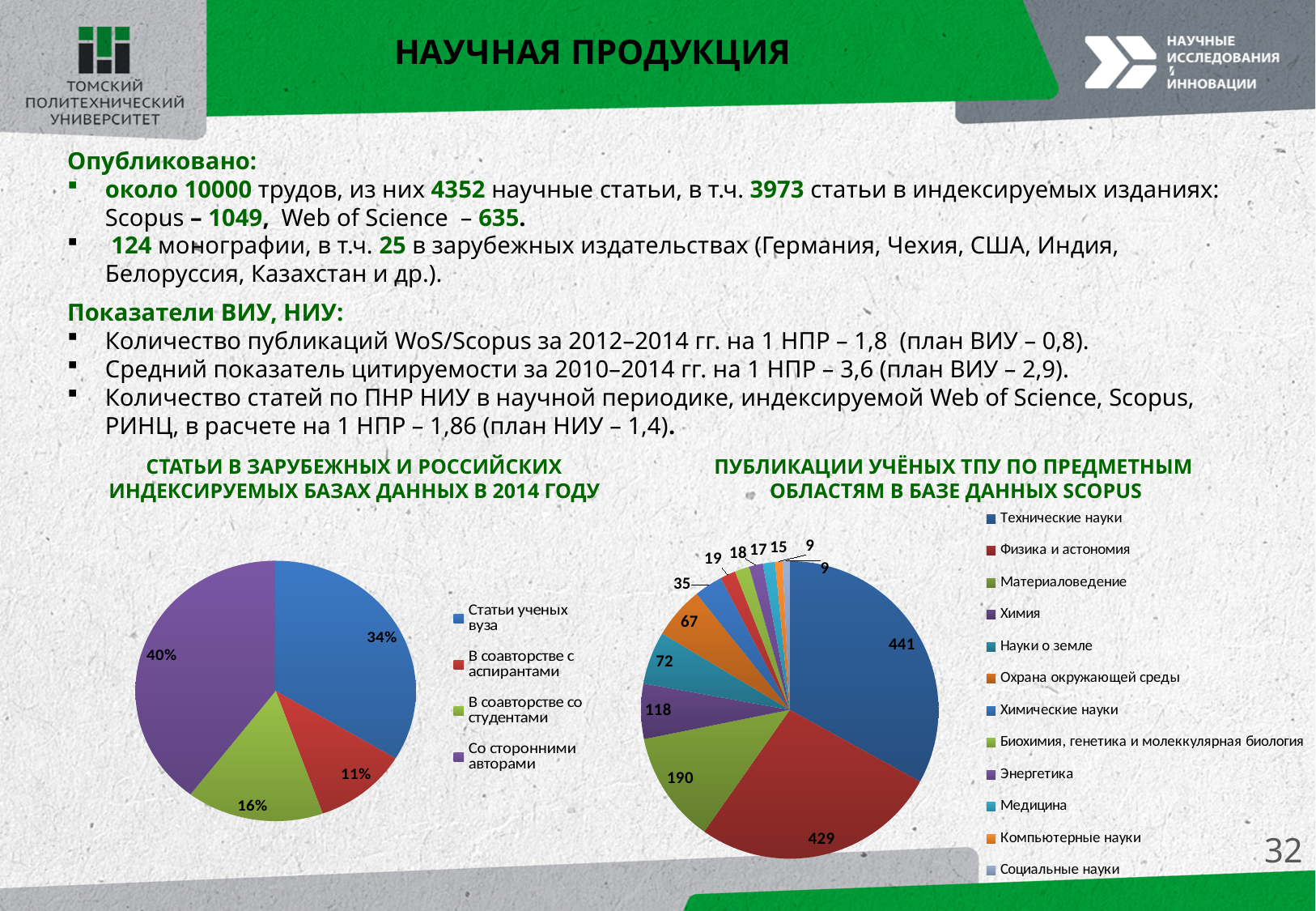
In the left pie chart, which category has the smallest share? В соавторстве с аспирантами In the right pie chart, which subject area has the highest number of publications? Технические науки How many categories does the legend of the left pie chart list? 4 In the left pie chart, what is the difference between the shares for 'Статьи ученых вуза' and 'В соавторстве со студентами'? 18% In the right pie chart (Публикации учёных ТПУ по предметным областям в базе данных Scopus), what is the value for 'Технические науки'? 441 In the right pie chart, which is larger: 'Науки о земле' or 'Охрана окружающей среды'? Науки о земле In the right pie chart, what is the value for 'Материаловедение'? 190 In the left pie chart (Статьи в зарубежных и российских индексируемых базах данных в 2014 году), what share is labelled for 'Со сторонними авторами'? 40% What type of chart is used for the publications by subject area on the right? Pie chart In the left pie chart, which category has the largest share? Со сторонними авторами In the left pie chart, what share is labelled for 'В соавторстве с аспирантами'? 11% In the right pie chart, what is the difference between the values for 'Физика и астономия' and 'Химия'? 311